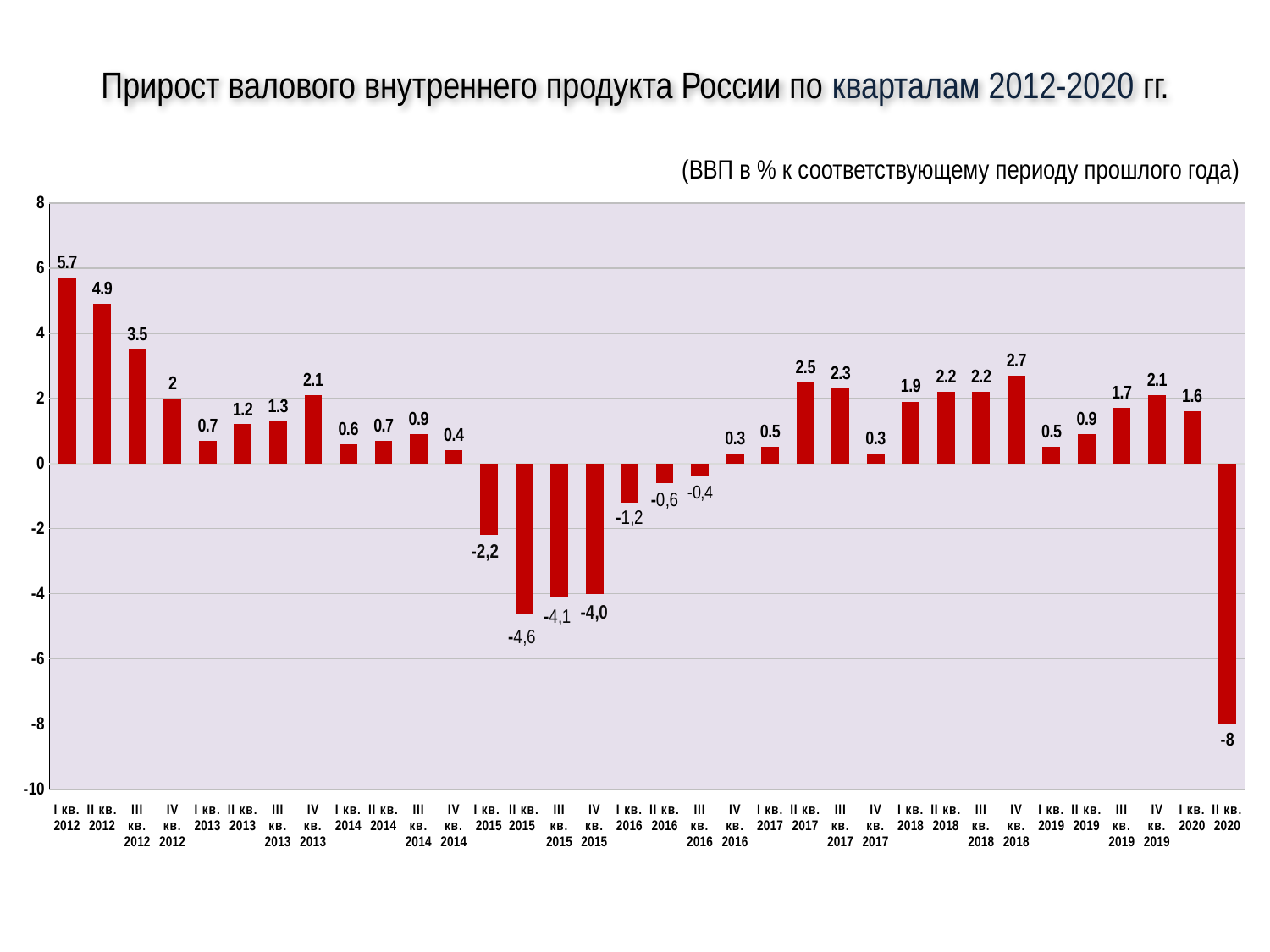
What is the value shown for II кв. 2020? -8 Which is larger, the value for II кв. 2017 or the value for III кв. 2017? II кв. 2017 What is the GDP growth value for I кв. 2012? 5.7 What is the value shown for II кв. 2015? -4,6 What is the difference between the values for I кв. 2012 and II кв. 2012? 0.8 Is the value for II кв. 2020 greater or less than -6? less Which quarter has the lowest GDP growth value? II кв. 2020 Which quarter has the highest GDP growth value? I кв. 2012 What type of chart is shown on the slide? Bar chart How many quarterly bars are plotted on the chart? 34 Do the values rise or fall from I кв. 2012 to IV кв. 2012? Fall What is the value shown for IV кв. 2018? 2.7